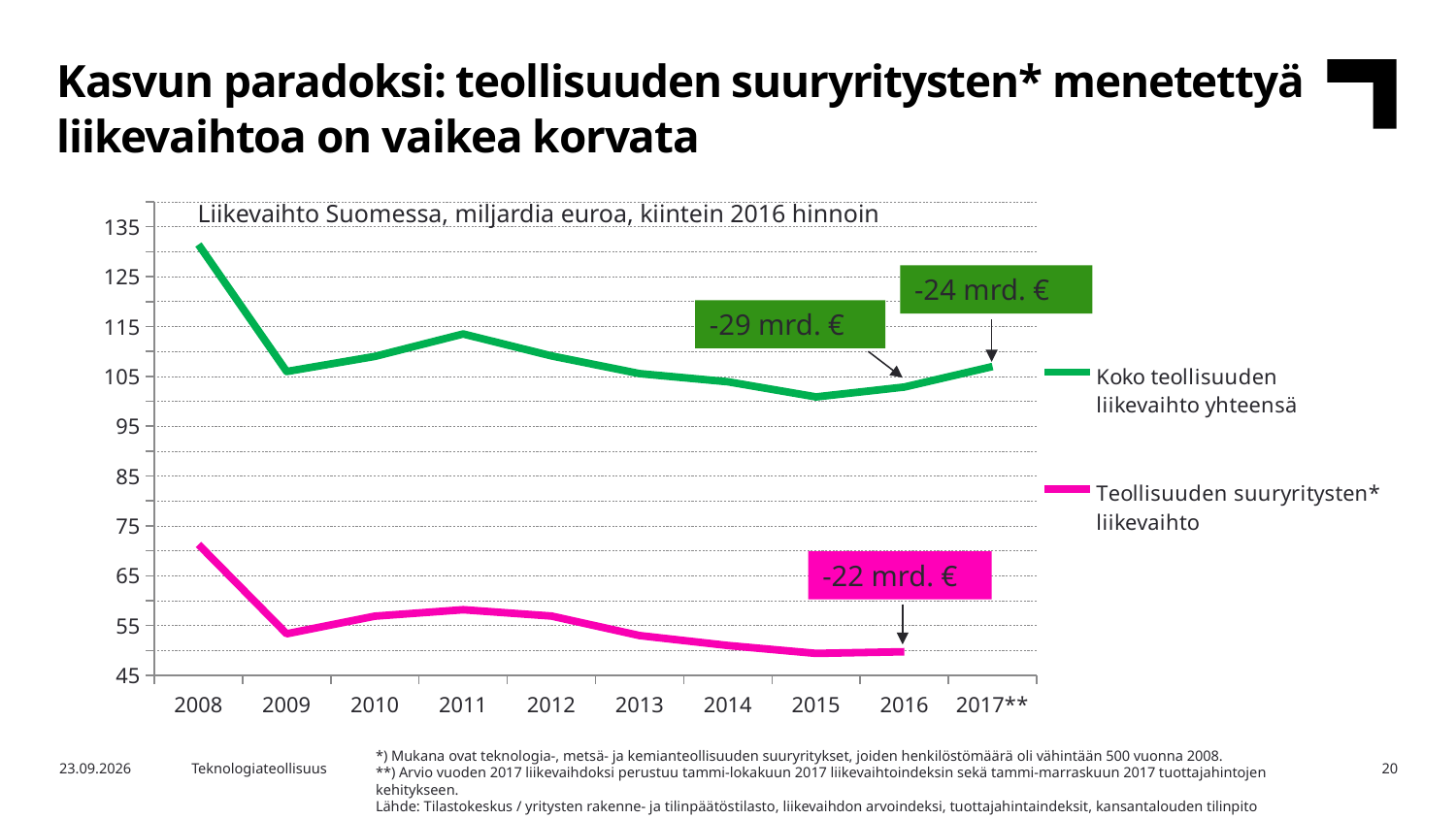
What is the title of the chart? Liikevaihto Suomessa, miljardia euroa, kiintein 2016 hinnoin What kind of chart is shown on the slide? line chart Is the value for Teollisuuden suuryritysten* liikevaihto in 2015 greater or less than 55? less Which year has the highest value for Teollisuuden suuryritysten* liikevaihto? 2008 Is the value for Koko teollisuuden liikevaihto yhteensä in 2015 greater or less than 105? less How many series does the legend list? 2 For Koko teollisuuden liikevaihto yhteensä, which is larger: the value in 2008 or the value in 2011? 2008 Is the value for Koko teollisuuden liikevaihto yhteensä in 2008 greater or less than 125? greater Does Teollisuuden suuryritysten* liikevaihto rise or fall from 2011 to 2015? fall How many years are shown on the x axis? 10 Which year has the highest value for Koko teollisuuden liikevaihto yhteensä? 2008